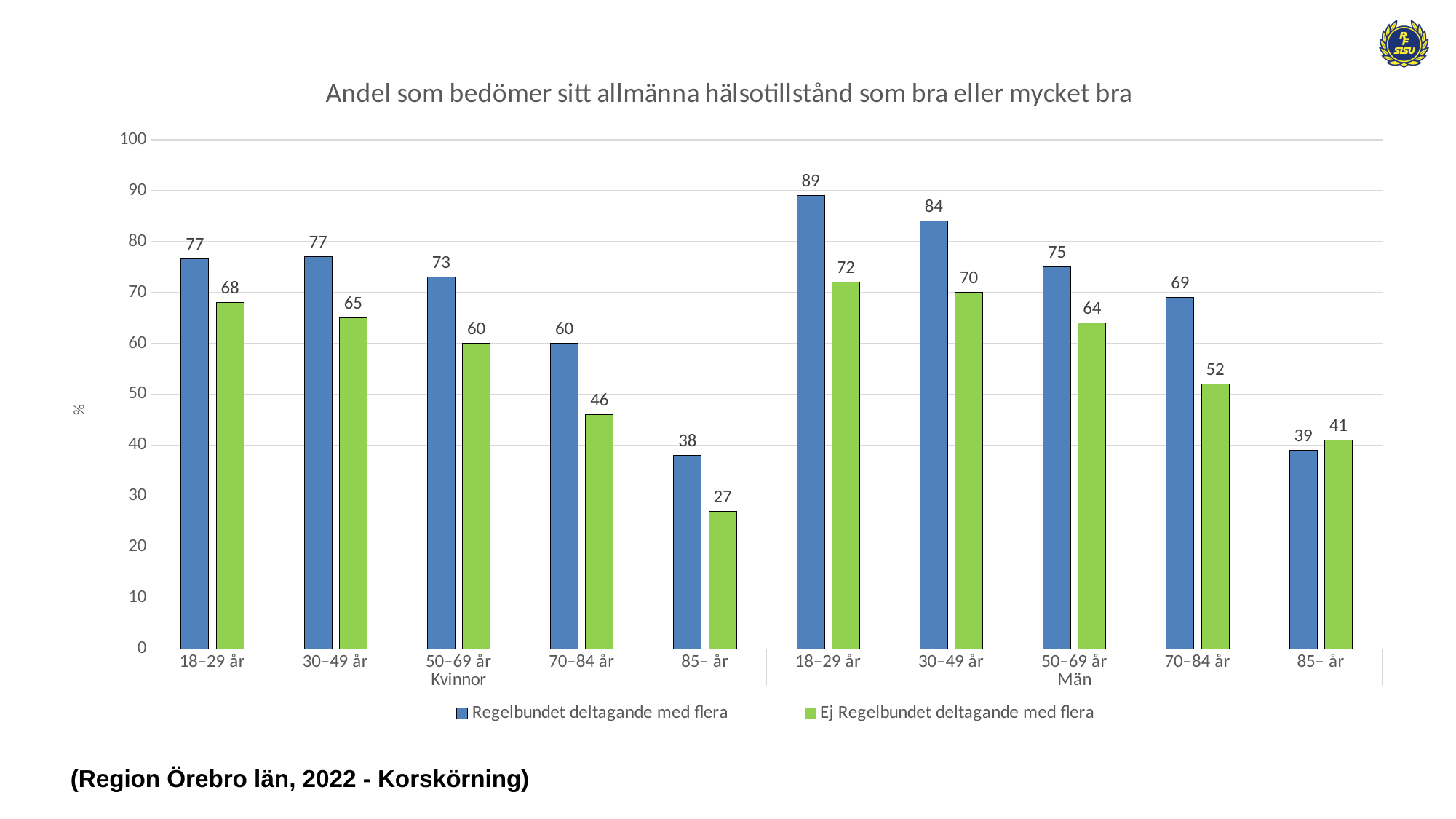
What is the difference between 'Regelbundet deltagande med flera' and 'Ej Regelbundet deltagande med flera' for Kvinnor aged 70–84 år? 14 Which group has the highest value for 'Regelbundet deltagande med flera'? Män 18–29 år Which group has the lowest value for 'Ej Regelbundet deltagande med flera'? Kvinnor 85– år What is the value for 'Ej Regelbundet deltagande med flera' for Män aged 70–84 år? 52 How many series does the legend list? 2 For Män aged 85– år, which is larger: 'Regelbundet deltagande med flera' or 'Ej Regelbundet deltagande med flera'? Ej Regelbundet deltagande med flera What is the title of the chart? Andel som bedömer sitt allmänna hälsotillstånd som bra eller mycket bra What is the value for 'Regelbundet deltagande med flera' for Kvinnor aged 18–29 år? 77 What kind of chart is shown on the slide? Bar chart Is the value for 'Regelbundet deltagande med flera' for Män aged 30–49 år greater or less than 80? greater Do the values for 'Regelbundet deltagande med flera' among Män rise or fall as age increases from 18–29 år to 85– år? Fall How many age groups are shown on the x axis in total (across Kvinnor and Män)? 10